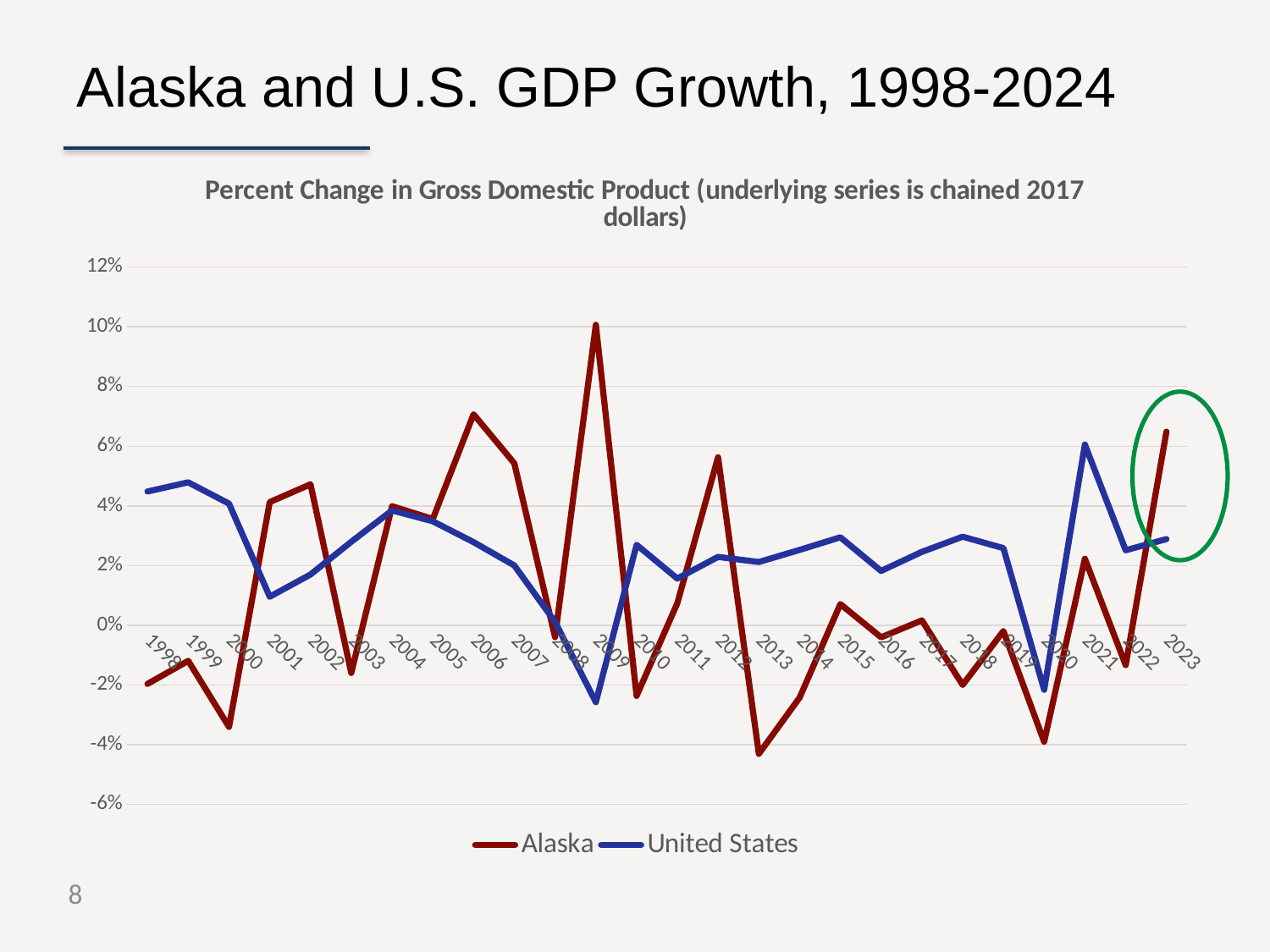
In which year does the Alaska series reach its highest value? 2009 How many years are plotted along the x axis? 26 Is the value for the United States in 2009 greater or less than -2%? less How many series does the legend list? 2 Is the value for Alaska in 2009 greater or less than 8%? greater Does the Alaska series rise or fall from 2006 to 2008? fall In 2012, which series has the larger value, Alaska or United States? Alaska In which year does the United States series reach its highest value? 2021 Is the value for Alaska in 2006 greater or less than 6%? greater In which year does the United States series reach its lowest value? 2009 What kind of chart is shown on the slide? line chart In 2021, which series has the larger value, Alaska or United States? United States